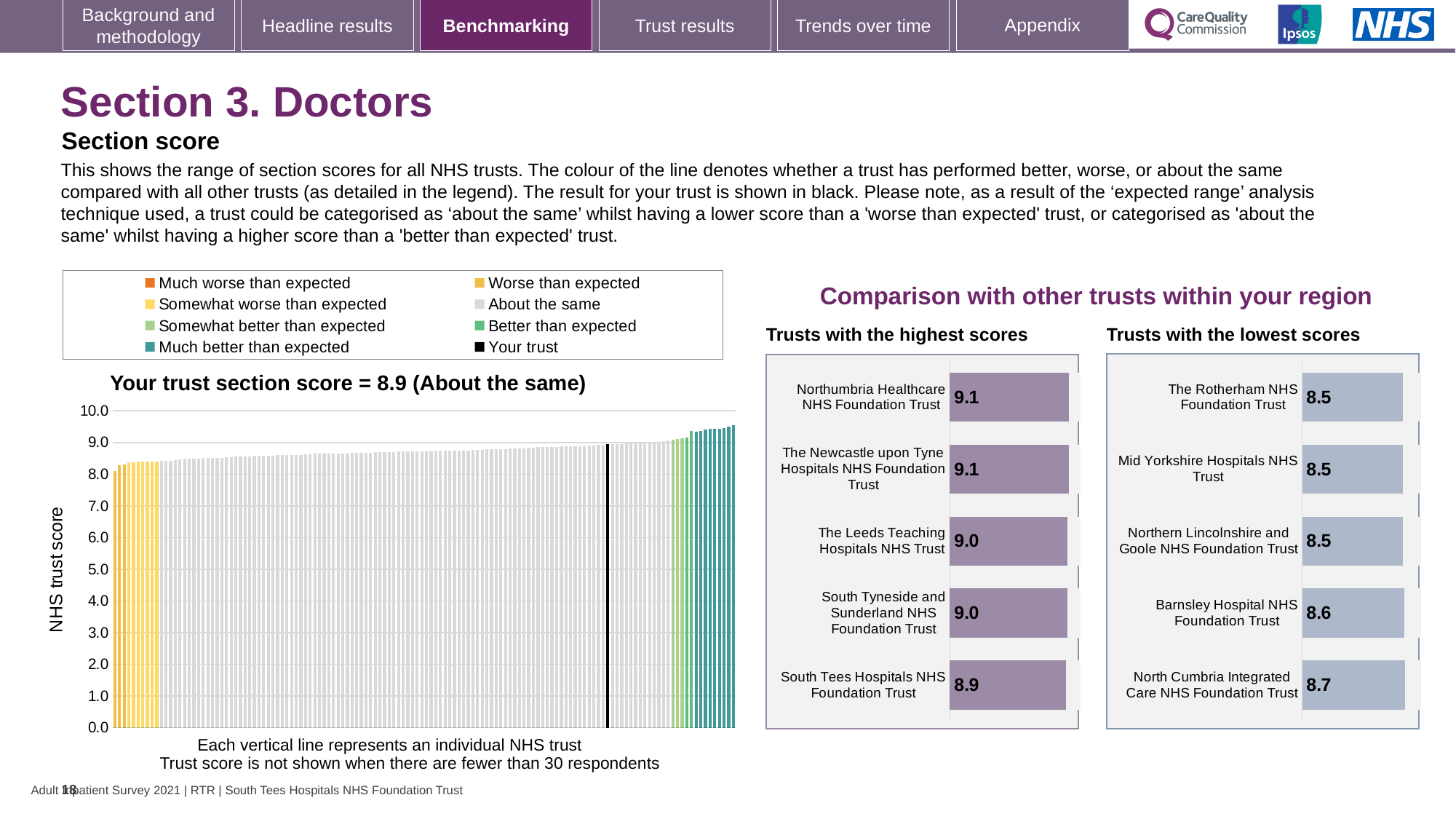
In the 'Trusts with the highest scores' chart, what is the score for The Leeds Teaching Hospitals NHS Trust? 9.0 In the 'Trusts with the lowest scores' chart, which has the larger score: Barnsley Hospital NHS Foundation Trust or North Cumbria Integrated Care NHS Foundation Trust? North Cumbria Integrated Care NHS Foundation Trust In the 'Trusts with the highest scores' chart, what is the difference between the scores of Northumbria Healthcare NHS Foundation Trust and South Tees Hospitals NHS Foundation Trust? 0.2 How many entries does the legend above the main chart list? 8 What kind of chart is the main chart showing the range of section scores for all NHS trusts? bar chart In the 'Trusts with the highest scores' chart, which trust has the lowest score? South Tees Hospitals NHS Foundation Trust In the 'Trusts with the lowest scores' chart, which trust has the highest score? North Cumbria Integrated Care NHS Foundation Trust How many trusts are shown in the 'Trusts with the lowest scores' chart? 5 In the 'Trusts with the lowest scores' chart, what is the score for Barnsley Hospital NHS Foundation Trust? 8.6 In the main chart 'Your trust section score', which category is your trust placed in? About the same In the main chart 'Your trust section score', what is the section score for your trust? 8.9 In the main chart, do the trust scores rise or fall from left to right along the x axis? rise